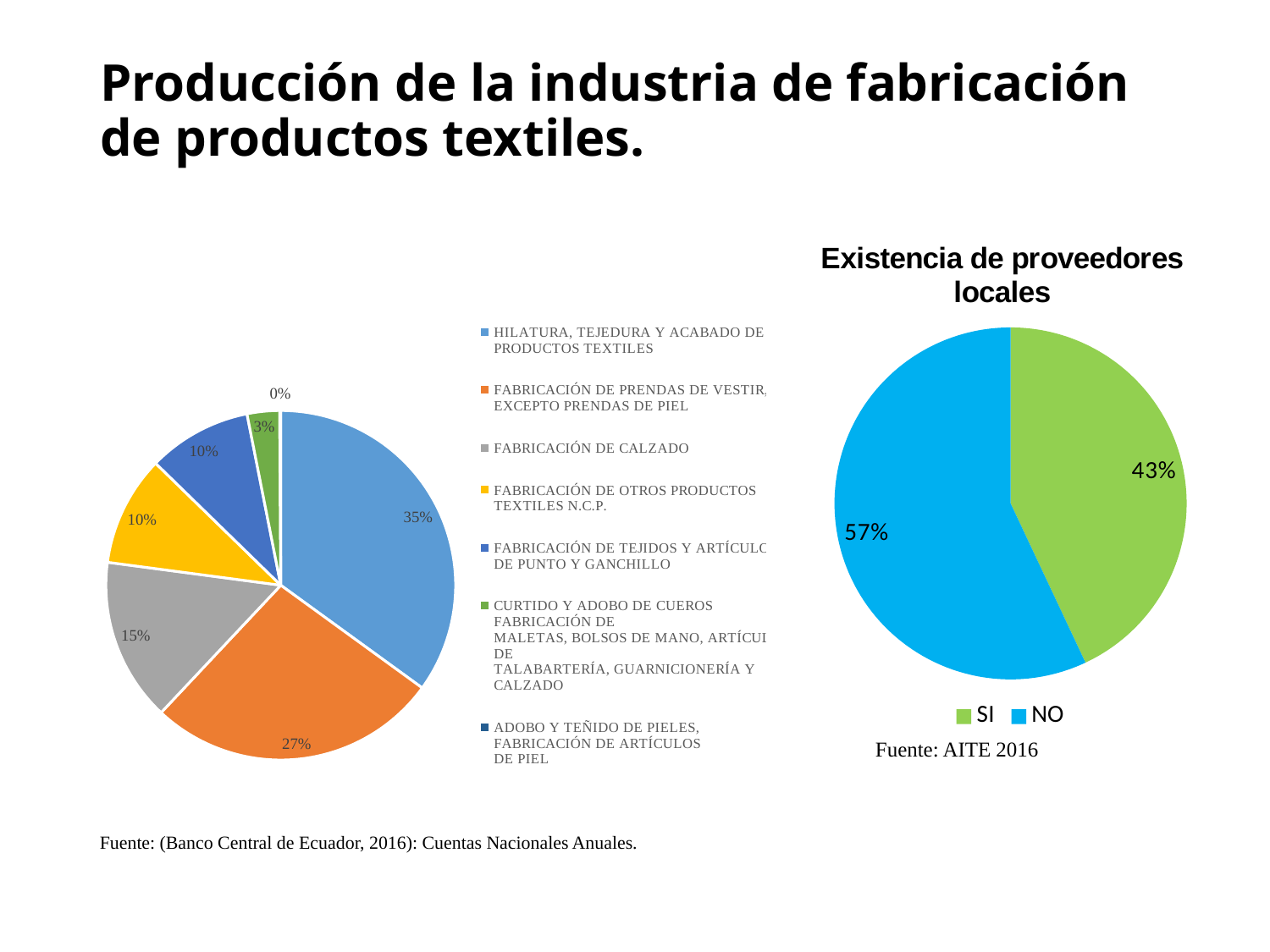
On the left pie chart, what share is labelled for FABRICACIÓN DE CALZADO? 15% On the left pie chart, what share is labelled for FABRICACIÓN DE PRENDAS DE VESTIR, EXCEPTO PRENDAS DE PIEL? 27% On the pie chart titled 'Existencia de proveedores locales', what is the difference between the NO share and the SI share? 14% On the pie chart titled 'Existencia de proveedores locales', what share is labelled for NO? 57% On the pie chart titled 'Existencia de proveedores locales', how many entries does the legend list? 2 On the pie chart titled 'Existencia de proveedores locales', which slice is larger, SI or NO? NO On the left pie chart, which category has the largest share? HILATURA, TEJEDURA Y ACABADO DE PRODUCTOS TEXTILES On the left pie chart, what share is labelled for HILATURA, TEJEDURA Y ACABADO DE PRODUCTOS TEXTILES? 35% On the left pie chart, what is the difference between the share for HILATURA, TEJEDURA Y ACABADO DE PRODUCTOS TEXTILES and the share for FABRICACIÓN DE CALZADO? 20% On the left pie chart, how many categories does the legend list? 7 What kind of chart is the chart titled 'Existencia de proveedores locales'? Pie chart On the pie chart titled 'Existencia de proveedores locales', what share is labelled for SI? 43%